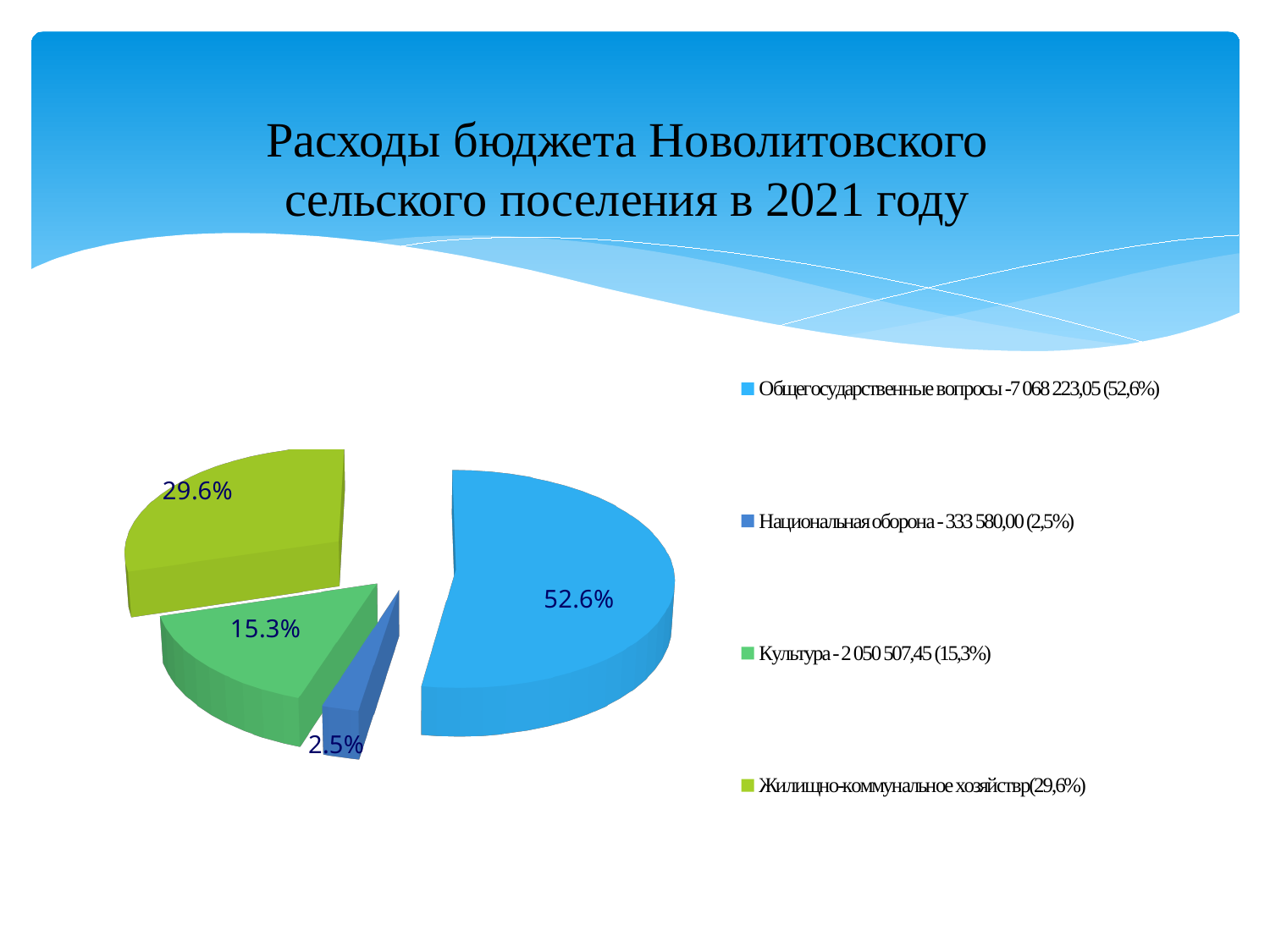
How many slices does the pie chart have? 4 What is the difference in percentage points between the Жилищно-коммунальное хозяйство slice and the Культура slice? 14.3 What share of the pie does Национальная оборона take? 2.5% What share of the pie does Культура take? 15.3% What is the title of the slide containing the chart? Расходы бюджета Новолитовского сельского поселения в 2021 году What kind of chart is shown on the slide? Pie chart What share of the pie does Общегосударственные вопросы take? 52.6% Which slice is larger, Культура or Жилищно-коммунальное хозяйство? Жилищно-коммунальное хозяйство Which category has the smallest slice of the pie? Национальная оборона How many entries does the legend list? 4 Which category has the largest slice of the pie? Общегосударственные вопросы